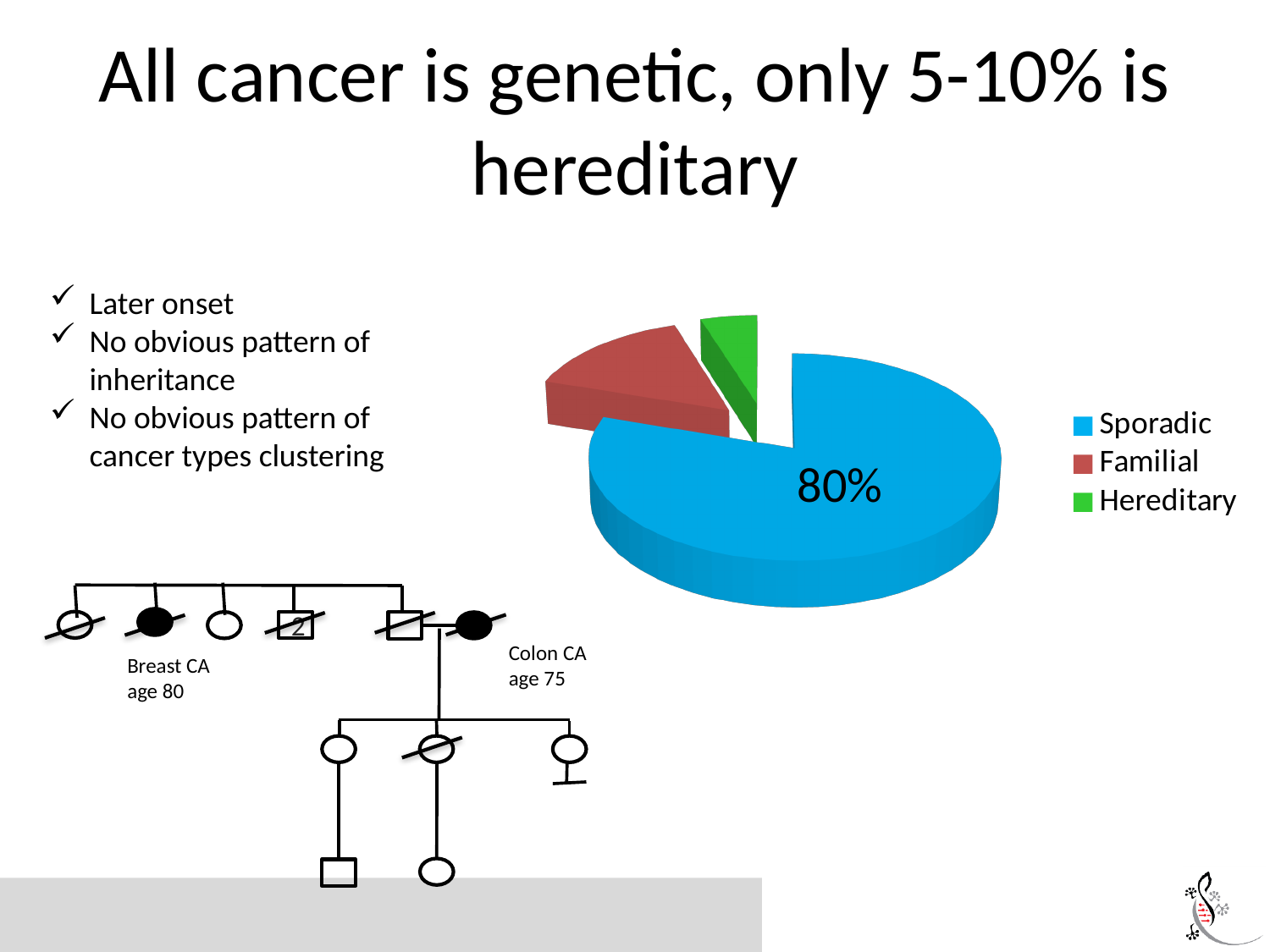
What percentage is shown on the Sporadic slice of the pie chart? 80% Which category has the largest slice in the pie chart? Sporadic How many slices does the pie chart have? 3 Which slice is larger in the pie chart, Familial or Hereditary? Familial What colour is the Hereditary slice in the pie chart? green What share of the pie does the Sporadic slice represent? 80% Which category has the smallest slice in the pie chart? Hereditary What kind of chart is shown on the slide? pie chart Which slice is larger in the pie chart, Sporadic or Familial? Sporadic Which category is shown in blue in the pie chart? Sporadic How many entries does the legend of the pie chart list? 3